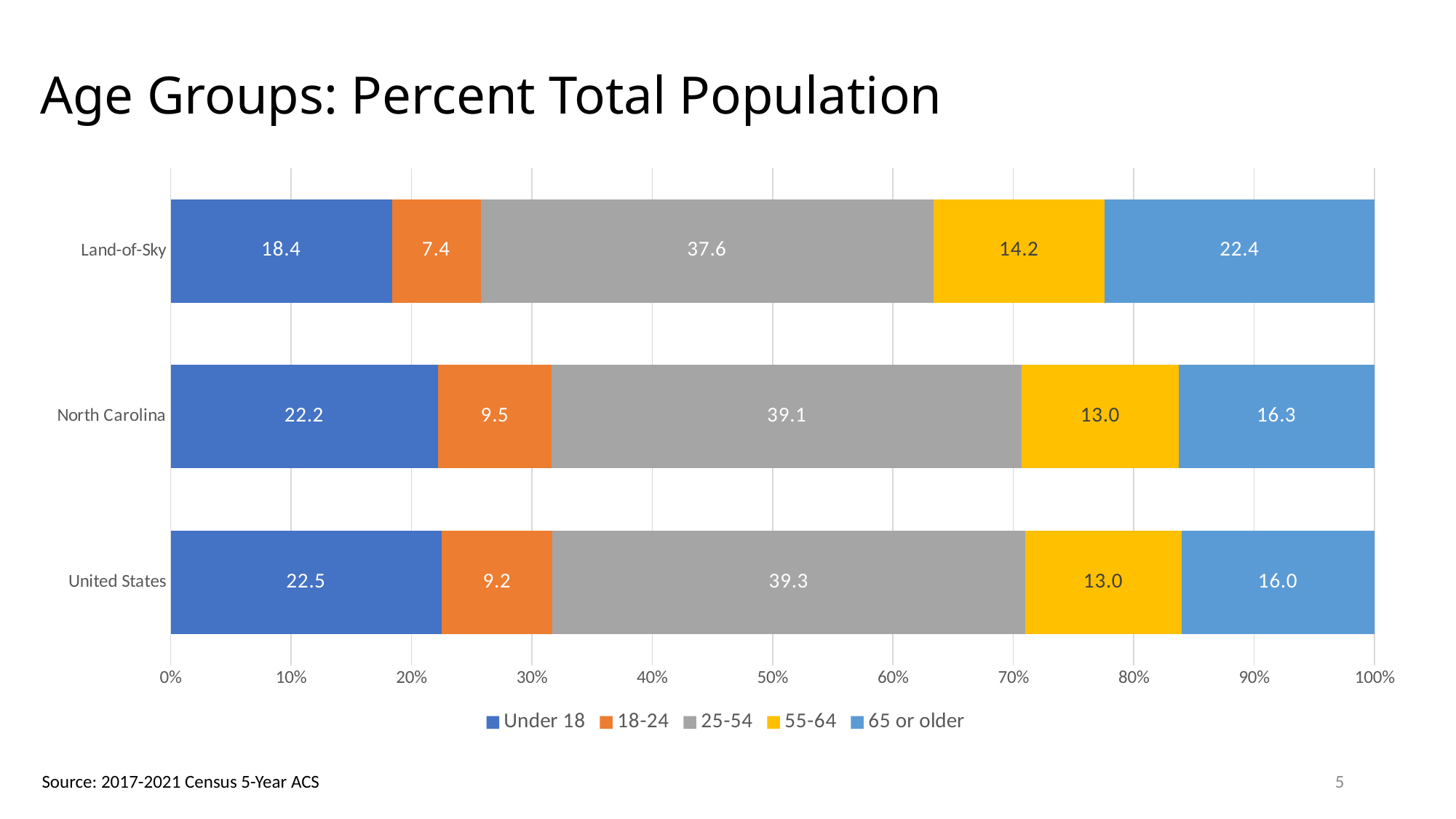
Which region has the lowest value for the Under 18 age group? Land-of-Sky What kind of chart is shown on the slide? Stacked bar chart How many regions are shown on the chart? 3 What is the title of the chart? Age Groups: Percent Total Population What is the value for the 25-54 age group in Land-of-Sky? 37.6 Which region has the highest value for the 65 or older age group? Land-of-Sky What colour represents the 55-64 age group in the chart? Yellow How many age groups does the legend list? 5 Which is larger: the 55-64 value for Land-of-Sky or for North Carolina? Land-of-Sky What is the difference between the Under 18 values for the United States and Land-of-Sky? 4.1 What is the value for the 18-24 age group in the United States? 9.2 What is the value for the 65 or older age group in North Carolina? 16.3